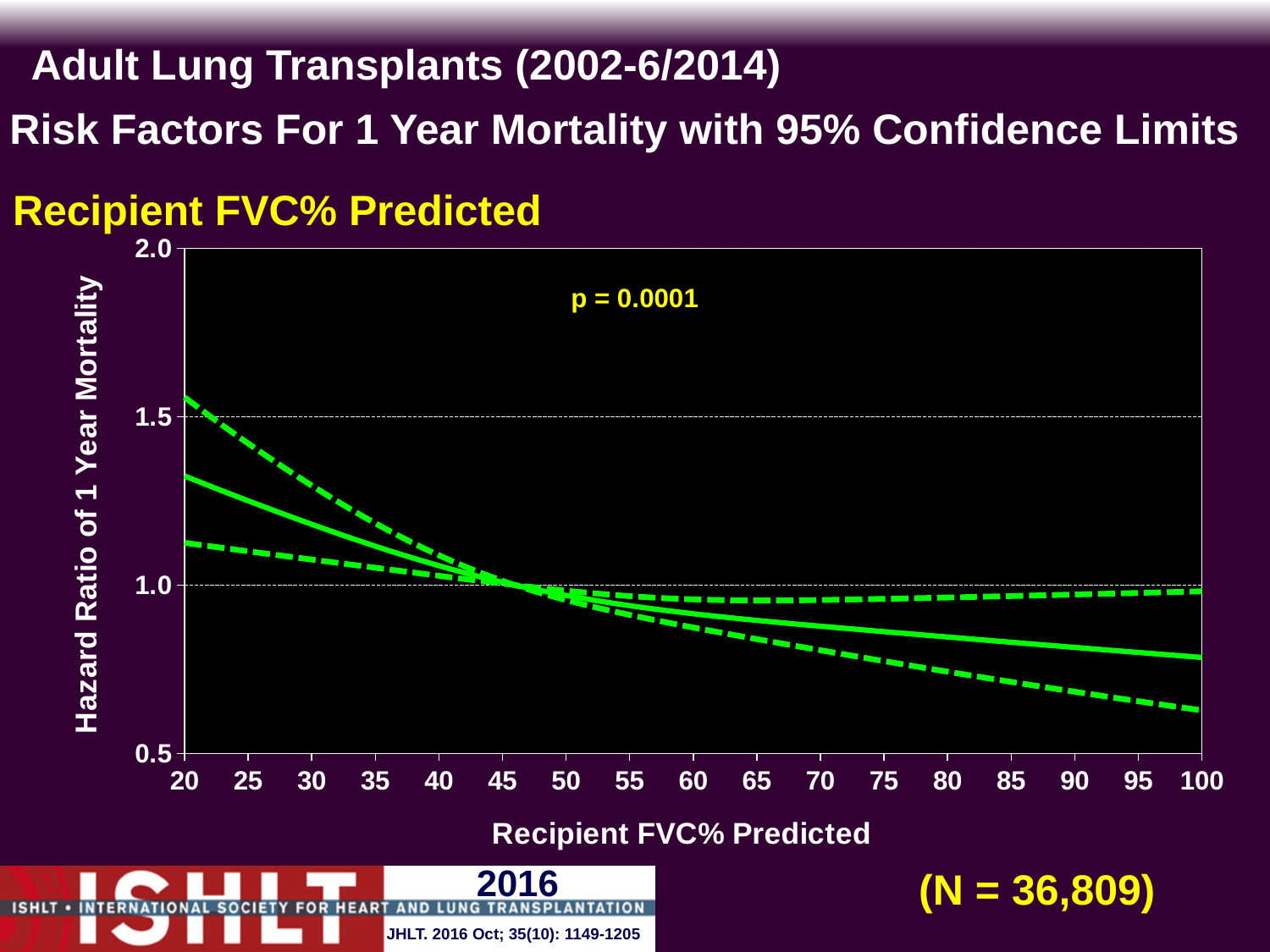
What kind of chart is shown on the slide? line chart Does the hazard ratio of 1 year mortality rise or fall as Recipient FVC% Predicted increases from 20 to 100? fall Is the lower 95% confidence limit at a Recipient FVC% Predicted of 100 greater or less than 0.5? greater Which has the larger hazard ratio on the solid line: a Recipient FVC% Predicted of 30 or of 80? 30 How many lines are plotted on the chart? 3 What is the label of the y axis? Hazard Ratio of 1 Year Mortality What p-value is printed on the chart? p = 0.0001 Is the upper 95% confidence limit at a Recipient FVC% Predicted of 20 greater or less than 1.5? greater Is the hazard ratio (solid line) at a Recipient FVC% Predicted of 100 greater or less than 1.0? less At which Recipient FVC% Predicted value shown on the x axis is the hazard ratio (solid line) lowest? 100 At which Recipient FVC% Predicted value shown on the x axis is the hazard ratio (solid line) highest? 20